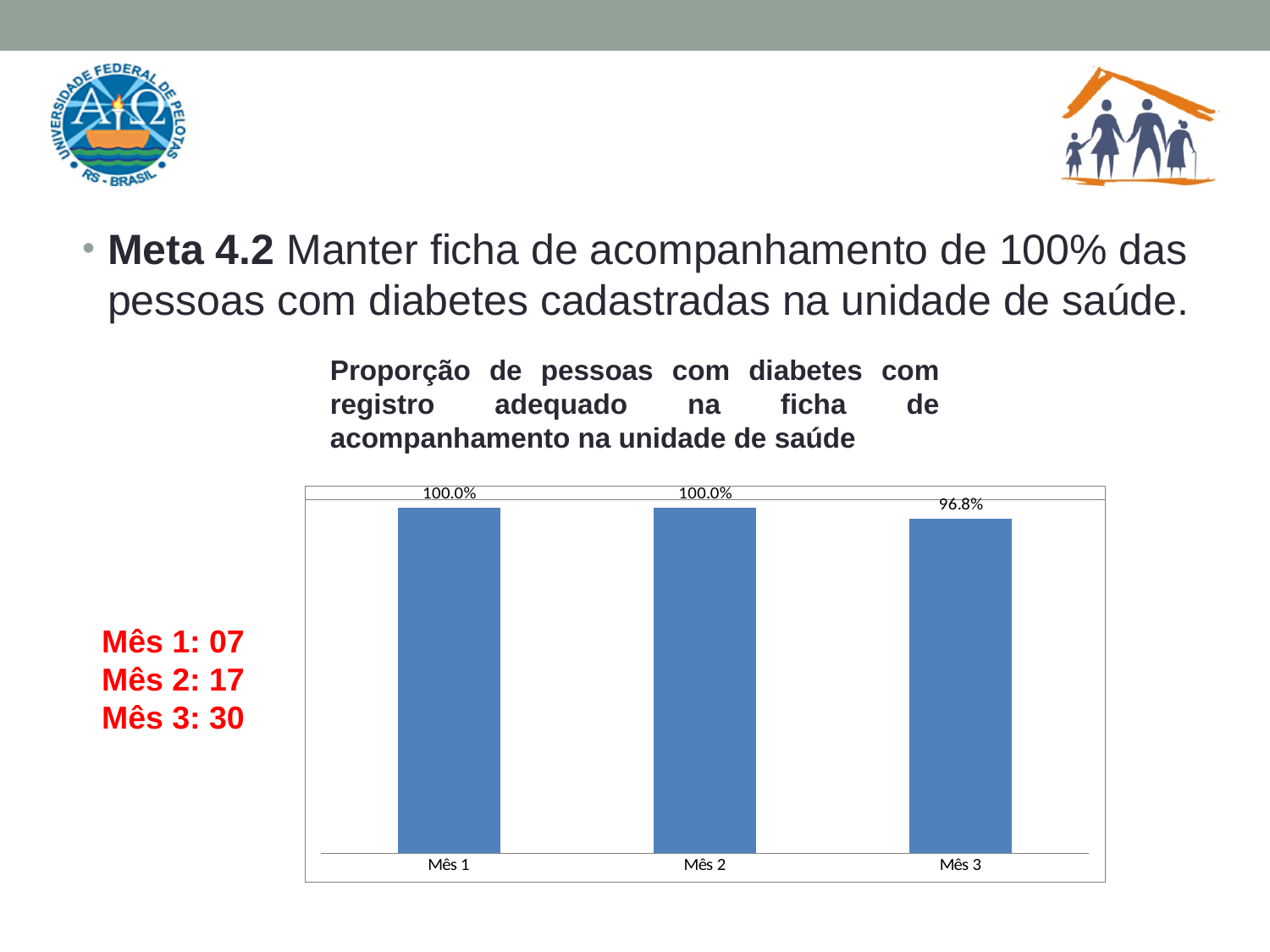
What is the value for Mês 2? 100.0% What is the value for Mês 1? 100.0% Which is larger, the value for Mês 2 or the value for Mês 3? Mês 2 Are the values for Mês 1 and Mês 2 equal? Yes How many months are shown on the x axis? 3 What colour are the bars in the chart? Blue Do the values rise or fall from Mês 2 to Mês 3? Fall What kind of chart is shown? Bar chart What is the title of the chart? Proporção de pessoas com diabetes com registro adequado na ficha de acompanhamento na unidade de saúde Which month has the lowest value? Mês 3 What is the value for Mês 3? 96.8% What is the difference between the values for Mês 1 and Mês 3? 3.2%